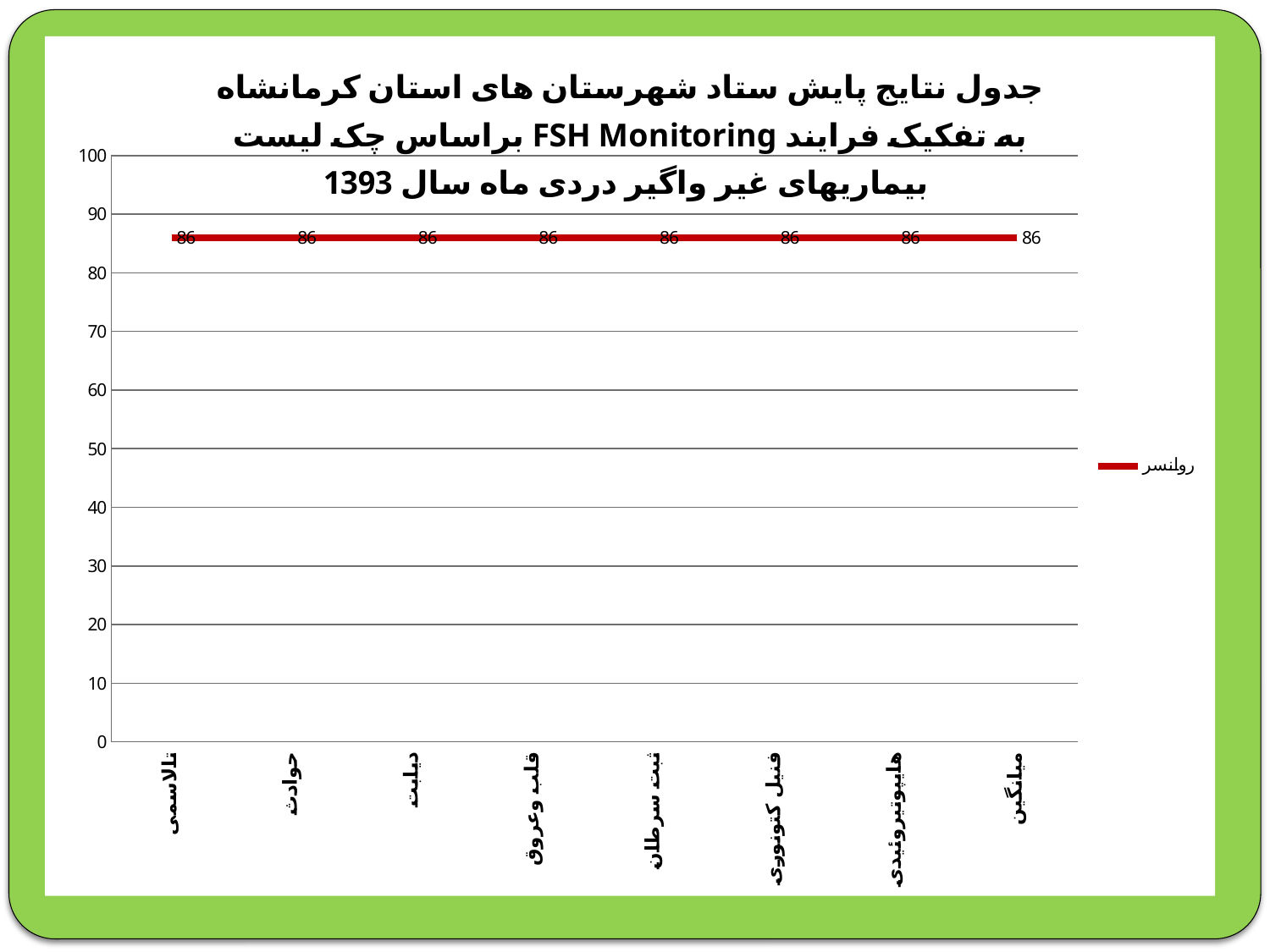
Is the value for حوادث greater or less than 80? greater How many categories are plotted along the x axis? 8 How many series does the legend list? 1 Do the values rise, fall, or stay flat across the categories along the x axis? stay flat What is the value for ثبت سرطان? 86 What is the value for تالاسمی? 86 What is the value for دیابت? 86 What is the value for میانگین? 86 Is the value for هایپوتیروئیدی greater or less than 90? less What is the difference between the values for قلب و عروق and فنیل کتونوری? 0 What is the name of the series shown in the legend? روانسر What kind of chart is shown on the slide? line chart